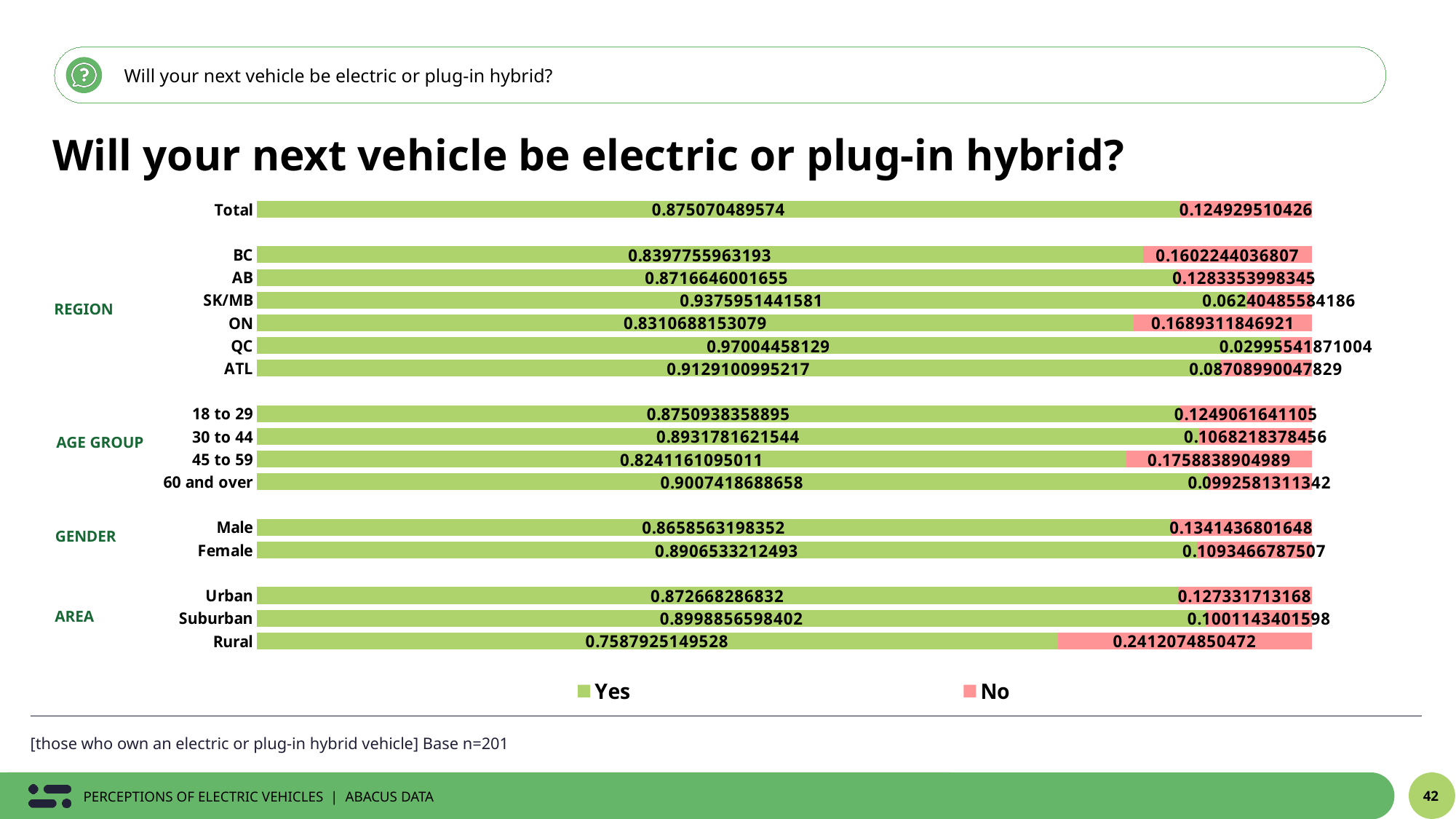
What is the Yes value for QC? 0.97004458129 What is the No value for ON? 0.1689311846921 What is the total of the stacked bar for Total (Yes plus No)? 1 Which has a larger Yes value, Male or Female? Female How many series does the legend list? 2 Which category has the lowest Yes value? Rural Which has a larger No value, BC or AB? BC What kind of chart is shown on the slide? Stacked bar chart How many categories (bars) are shown in the chart? 16 Which category has the highest Yes value? QC What is the No value for 45 to 59? 0.1758838904989 What is the Yes value for Rural? 0.7587925149528